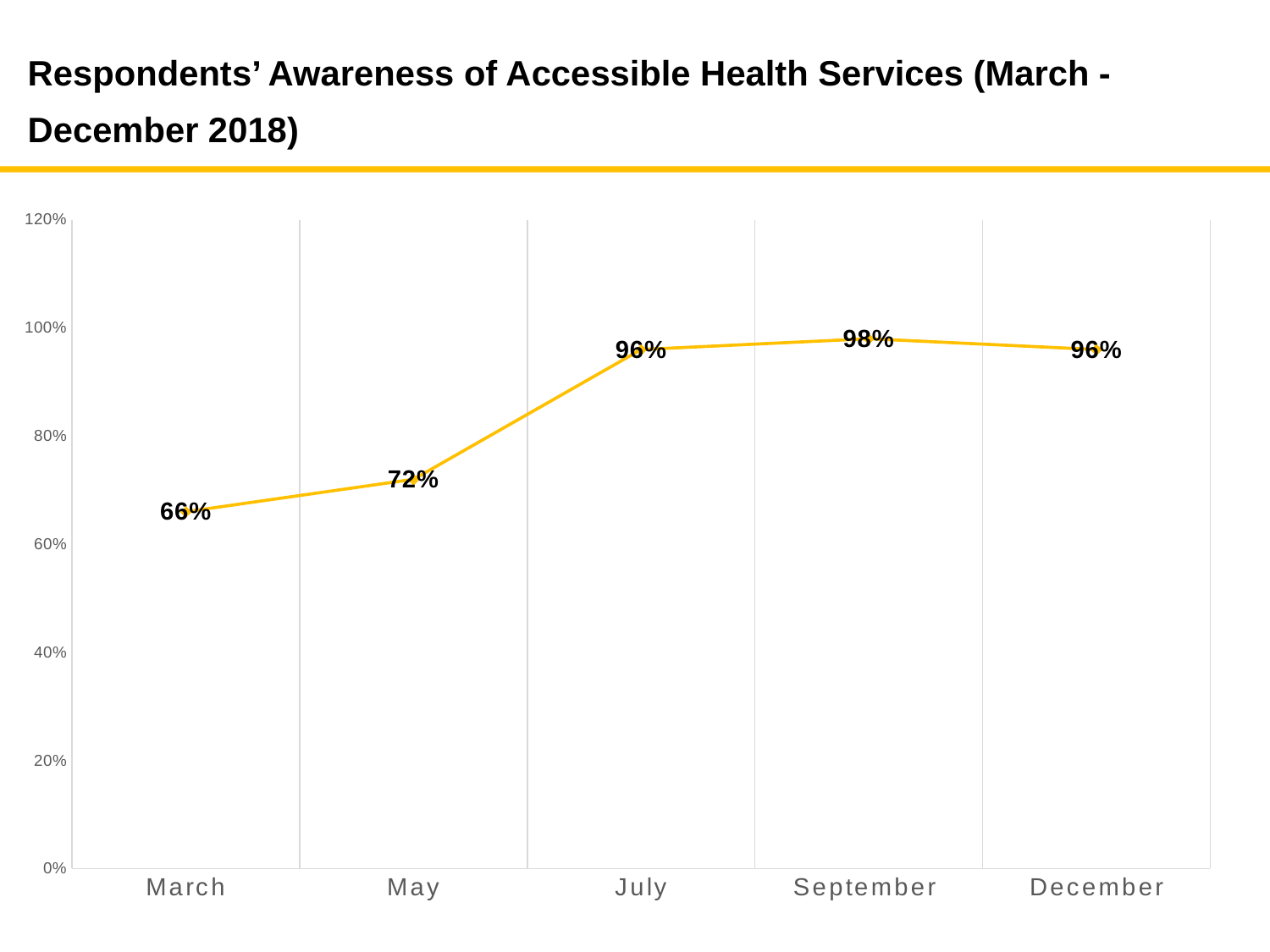
Which month has the highest value? September What is the value for September? 98% Which is larger, the value for May or the value for July? July Do the values rise or fall from March to September? Rise What is the value for December? 96% What is the difference between the values for May and March? 6% What is the value for March? 66% Which month has the lowest value? March What kind of chart is shown on the slide? Line chart What is the difference between the values for July and March? 30% What is the value for May? 72% How many data points are plotted on the chart? 5